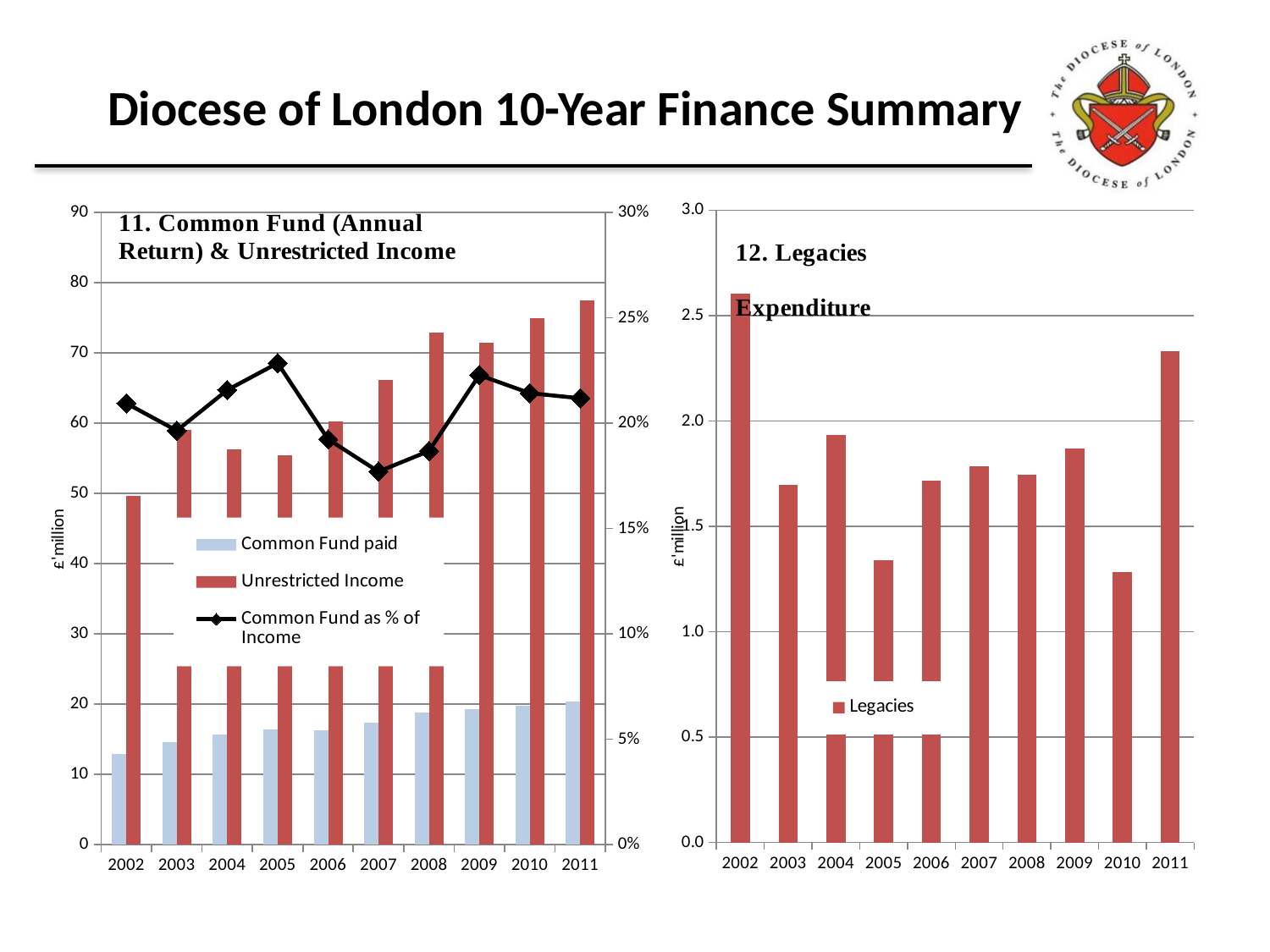
On the chart titled "11. Common Fund (Annual Return) & Unrestricted Income", how many series does the legend list? 3 On the chart titled "11. Common Fund (Annual Return) & Unrestricted Income", does Common Fund paid rise or fall from 2002 to 2011? rise On the chart titled "12. Legacies", how many years are shown on the x axis? 10 What kind of chart is the chart titled "12. Legacies"? bar chart On the chart titled "11. Common Fund (Annual Return) & Unrestricted Income", in which year is Unrestricted Income highest? 2011 On the chart titled "12. Legacies", is the value for 2011 greater or less than 2.0? greater On the chart titled "11. Common Fund (Annual Return) & Unrestricted Income", in which year is Unrestricted Income lowest? 2002 On the chart titled "11. Common Fund (Annual Return) & Unrestricted Income", is the Common Fund as % of Income value for 2007 greater or less than 20%? less On the chart titled "11. Common Fund (Annual Return) & Unrestricted Income", which is larger, Unrestricted Income in 2009 or in 2010? 2010 On the chart titled "11. Common Fund (Annual Return) & Unrestricted Income", in which year is Common Fund as % of Income lowest? 2007 On the chart titled "11. Common Fund (Annual Return) & Unrestricted Income", is the Unrestricted Income value for 2011 greater or less than 70? greater On the chart titled "12. Legacies", in which year are Legacies highest? 2002